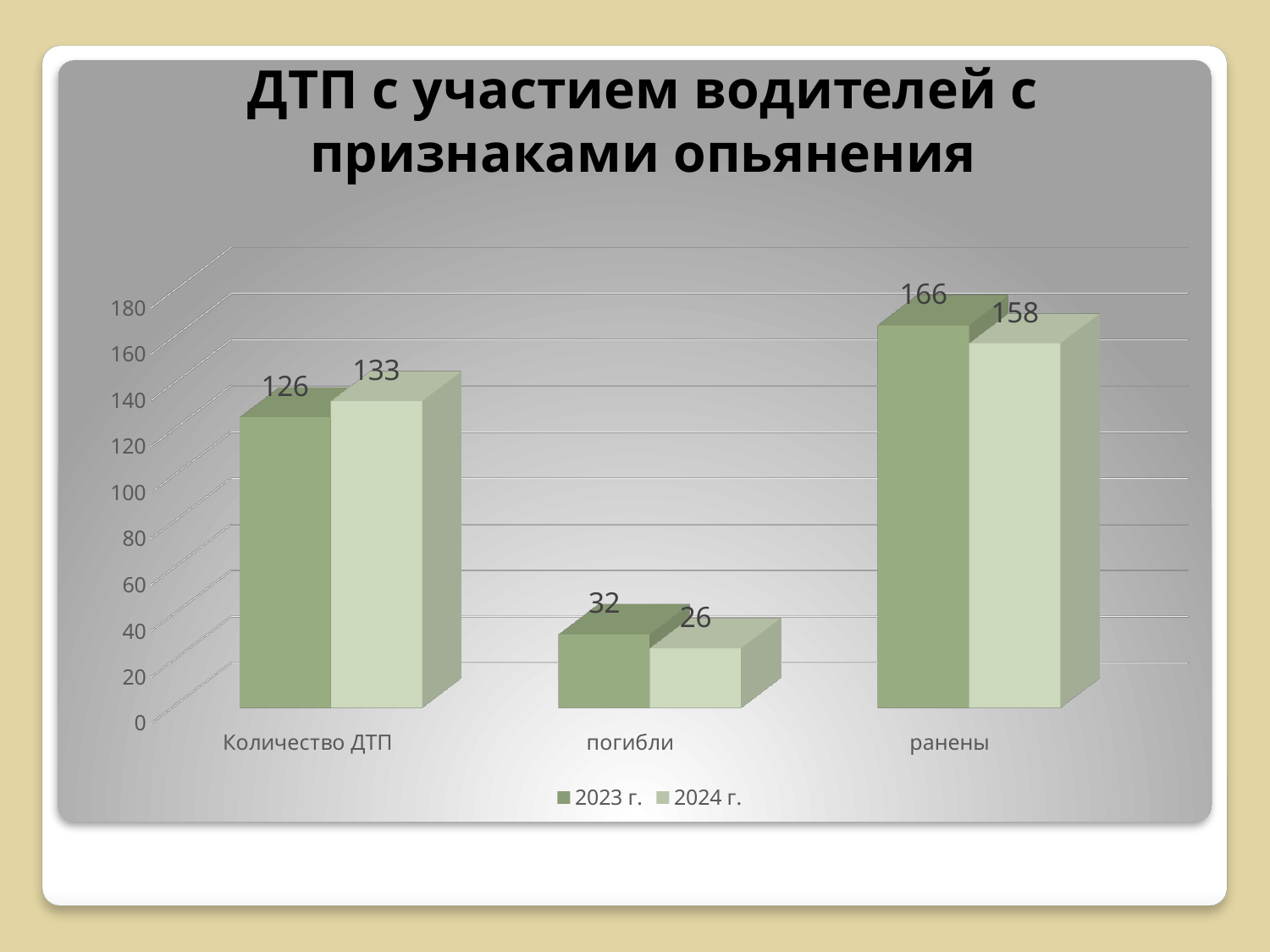
What kind of chart is shown on the slide? bar chart What is the value for "Количество ДТП" in the 2023 г. series? 126 Which category has the highest value in the 2023 г. series? ранены How many categories are shown on the x axis? 3 What is the difference between the 2024 г. and 2023 г. values for "Количество ДТП"? 7 What is the value for "ранены" in the 2024 г. series? 158 For "погибли", which series has the larger value, 2023 г. or 2024 г.? 2023 г. What is the value for "Количество ДТП" in the 2024 г. series? 133 Which category has the lowest value in the 2024 г. series? погибли How many series does the legend list? 2 What is the value for "погибли" in the 2023 г. series? 32 What is the difference between the 2023 г. and 2024 г. values for "ранены"? 8